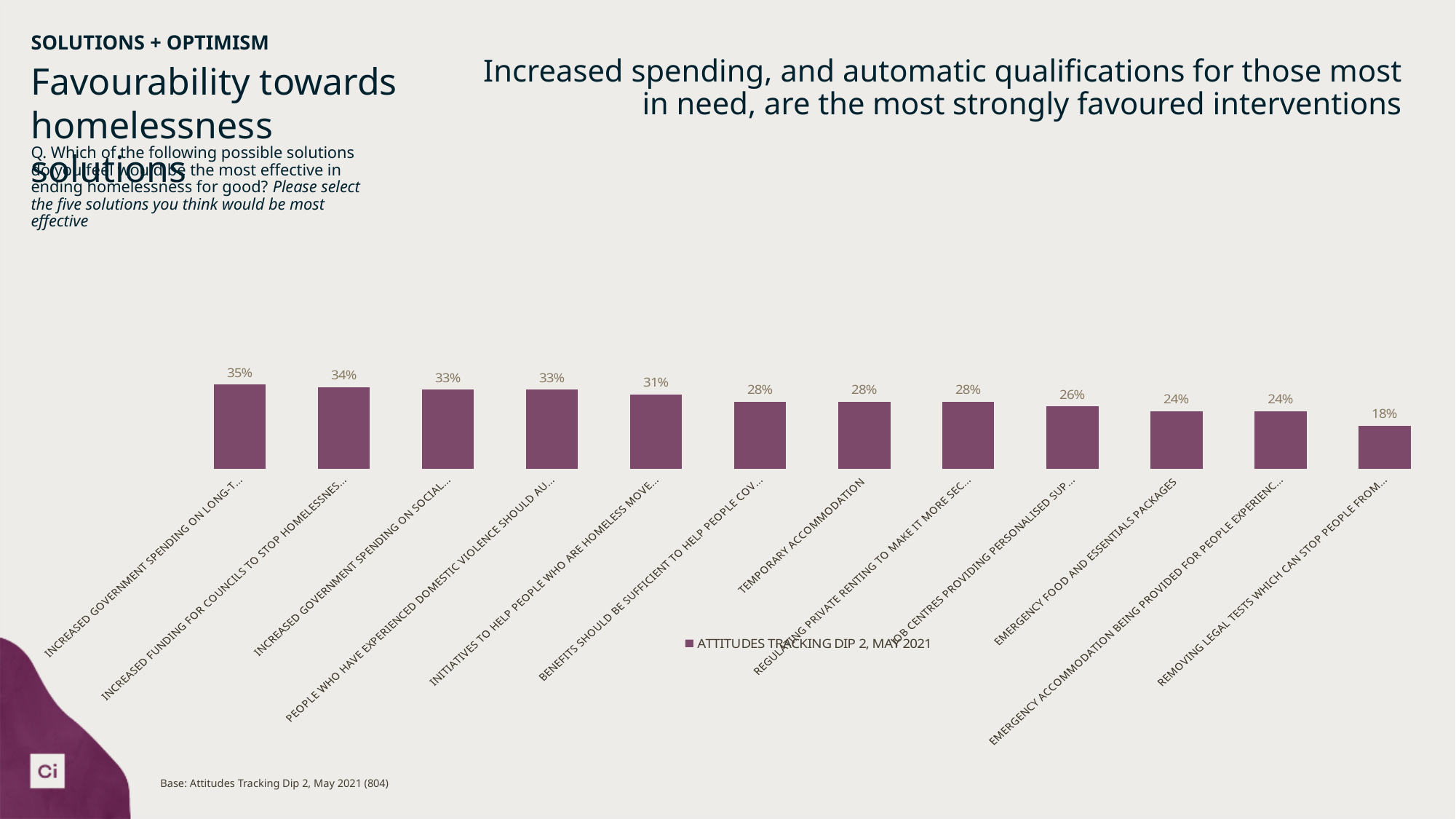
What is the value for Emergency food and essentials packages? 24% What kind of chart is shown on the slide? Bar chart How many bars are shown in the chart? 12 What is the lowest value shown in the chart? 18% What is the difference between the highest and lowest values in the chart? 17 percentage points What is the value of the leftmost bar in the chart? 35% How many series does the legend list? 1 What is the difference between the values for Temporary accommodation and Emergency food and essentials packages? 4 percentage points Which has a higher value: Temporary accommodation or Emergency food and essentials packages? Temporary accommodation What is the value for Temporary accommodation? 28% Do the values rise or fall from left to right across the chart? Fall What is the highest value shown in the chart? 35%